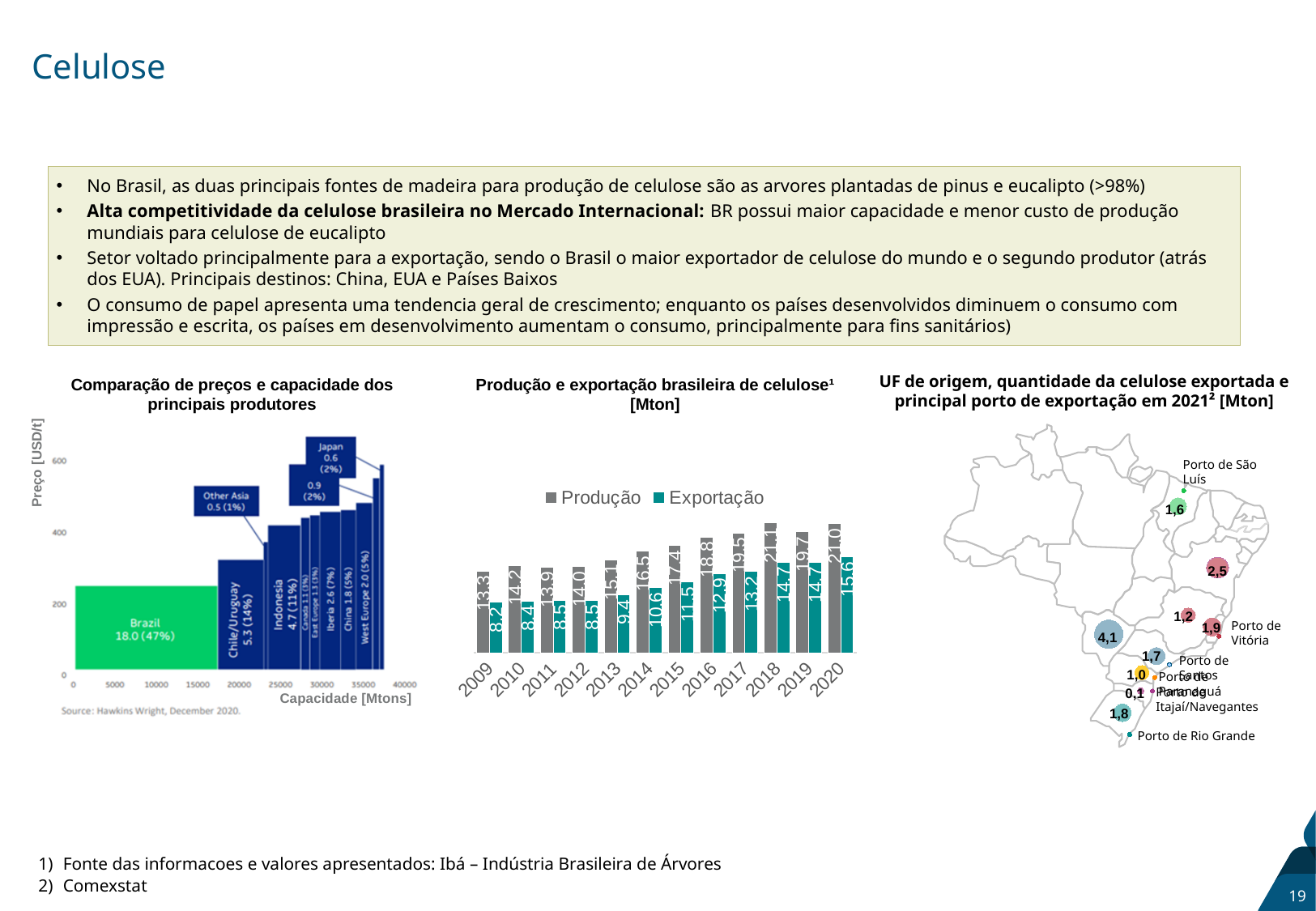
In the chart 'Produção e exportação brasileira de celulose [Mton]', how many series does the legend list? 2 In the chart 'Produção e exportação brasileira de celulose [Mton]', was production higher in 2019 or in 2020? 2020 In the chart 'Produção e exportação brasileira de celulose [Mton]', how many years are shown on the x axis? 12 In the chart 'Produção e exportação brasileira de celulose [Mton]', which year had the highest production? 2018 In the chart 'Produção e exportação brasileira de celulose [Mton]', what was the production value in 2018? 21.1 In the chart 'Produção e exportação brasileira de celulose [Mton]', which colour represents the Exportação series? Teal (green) In the chart 'Produção e exportação brasileira de celulose [Mton]', which year had the lowest export value? 2009 In the chart 'Produção e exportação brasileira de celulose [Mton]', do export values generally rise or fall from 2009 to 2020? Rise In the chart 'Comparação de preços e capacidade dos principais produtores', what capacity and share are shown for Brazil? 18.0 (47%) In the chart 'Produção e exportação brasileira de celulose [Mton]', what is the difference between production and export in 2020? 5.4 What kind of chart is 'Produção e exportação brasileira de celulose [Mton]'? Bar chart In the chart 'Produção e exportação brasileira de celulose [Mton]', what was the export value in 2020? 15.6